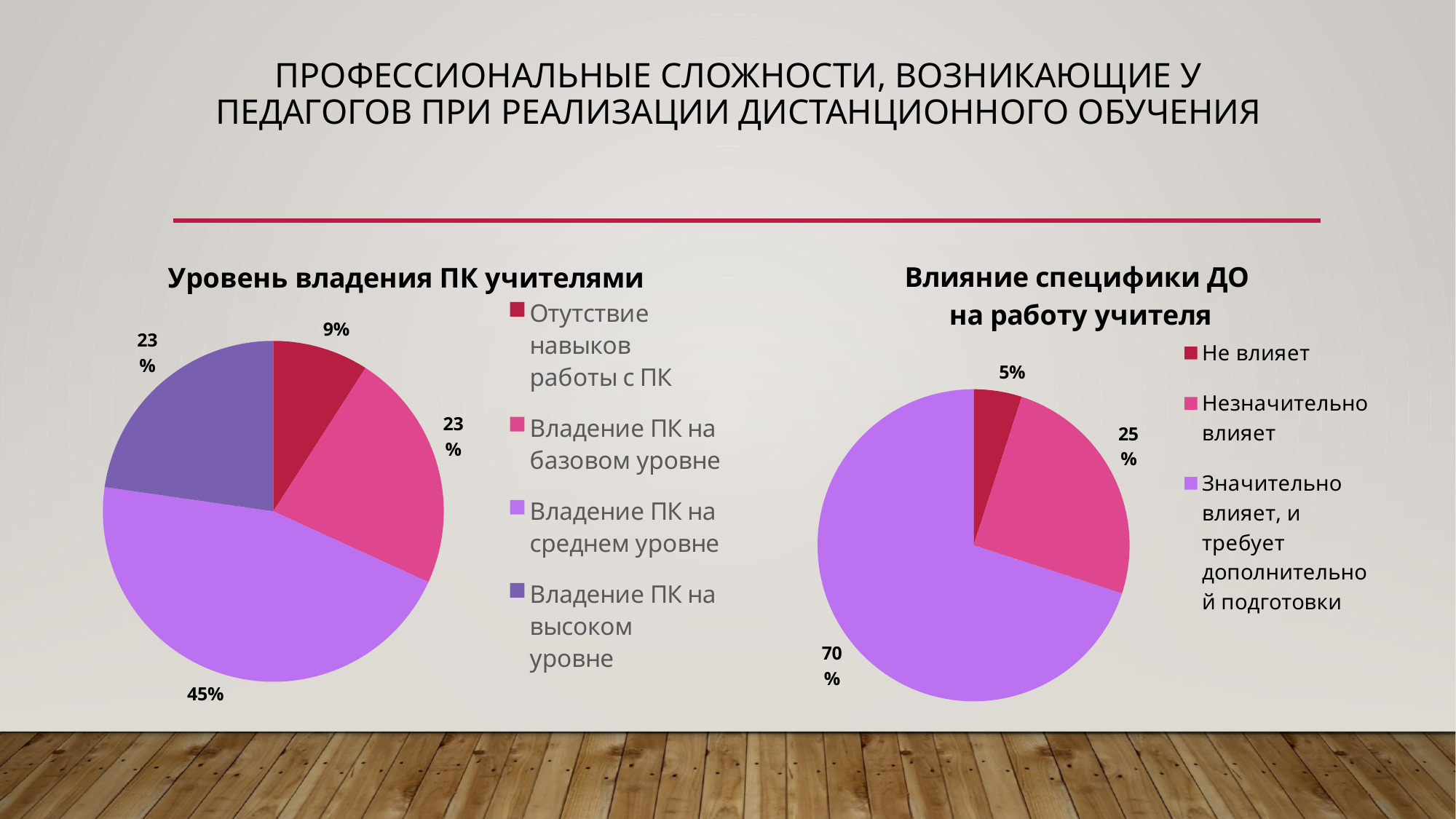
In the chart "Уровень владения ПК учителями", which category has the smallest slice? Отутствие навыков работы с ПК In the chart "Уровень владения ПК учителями", what is the difference between "Владение ПК на среднем уровне" and "Владение ПК на базовом уровне"? 22% In the chart "Влияние специфики ДО на работу учителя", which is larger: "Незначительно влияет" or "Не влияет"? Незначительно влияет In the chart "Влияние специфики ДО на работу учителя", what share is "Незначительно влияет"? 25% What kind of chart is "Уровень владения ПК учителями"? Pie chart In the chart "Уровень владения ПК учителями", how many categories does the legend list? 4 In the chart "Уровень владения ПК учителями", what share is "Отутствие навыков работы с ПК"? 9% In the chart "Влияние специфики ДО на работу учителя", which category has the largest slice? Значительно влияет, и требует дополнительной подготовки In the chart "Влияние специфики ДО на работу учителя", how many slices does the pie have? 3 In the chart "Уровень владения ПК учителями", what share is "Владение ПК на среднем уровне"? 45% In the chart "Уровень владения ПК учителями", which category has the largest slice? Владение ПК на среднем уровне In the chart "Влияние специфики ДО на работу учителя", what share is "Не влияет"? 5%